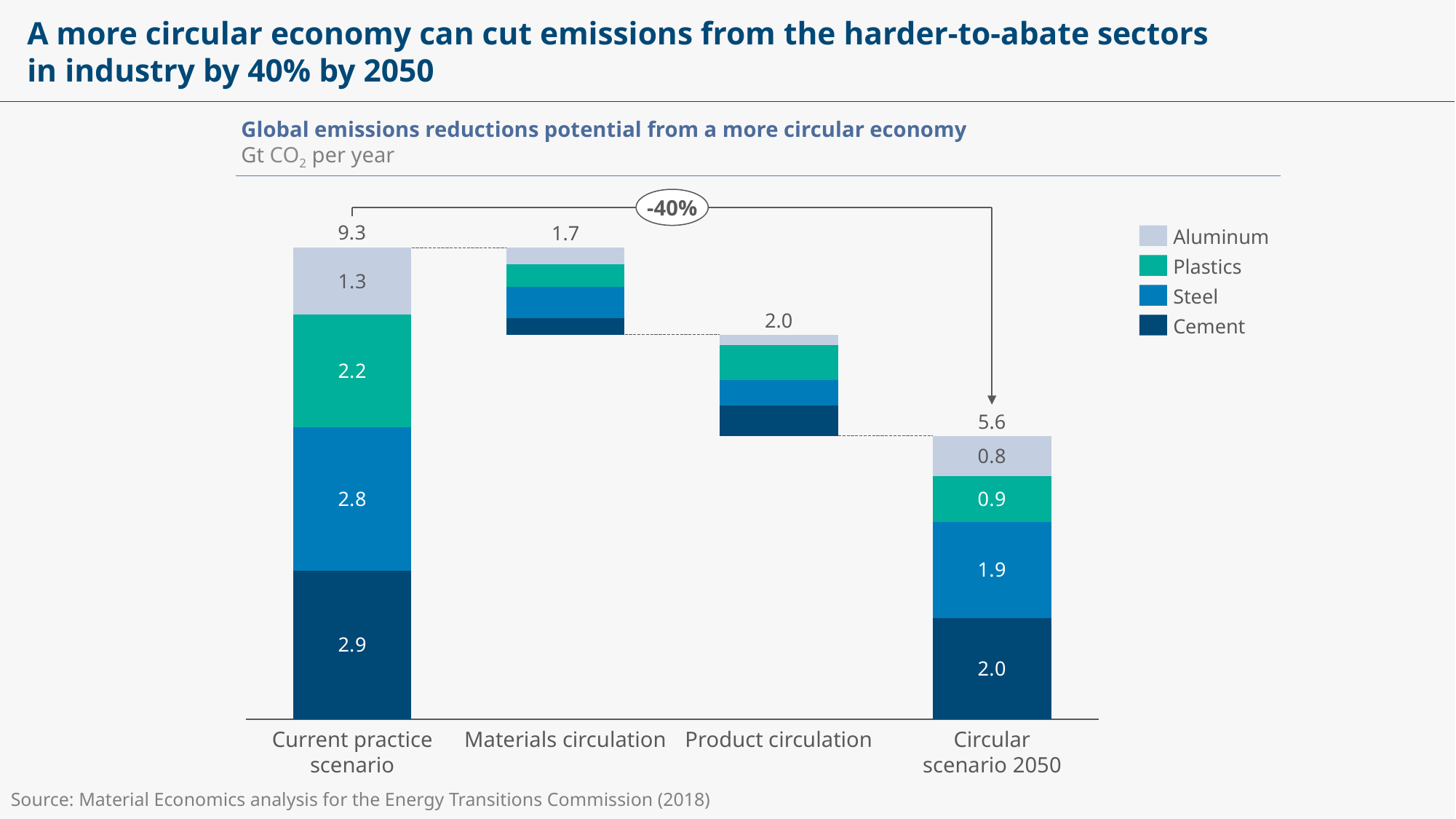
How many bars are shown on the chart? 4 Which bar has the highest total value? Current practice scenario What is the total value shown for the Materials circulation bar? 1.7 What is the Plastics value in the Current practice scenario bar? 2.2 What is the difference between the Steel value in the Current practice scenario and the Steel value in the Circular scenario 2050? 0.9 What is the total value shown for the Product circulation bar? 2.0 What is the Cement value in the Circular scenario 2050 bar? 2.0 What is the total value shown for the Current practice scenario bar? 9.3 What percentage reduction is labelled between the Current practice scenario and the Circular scenario 2050? -40% Which bar has the lowest total value? Materials circulation How many series does the legend list? 4 Which is larger: the Aluminum value in the Current practice scenario or the Aluminum value in the Circular scenario 2050? Current practice scenario